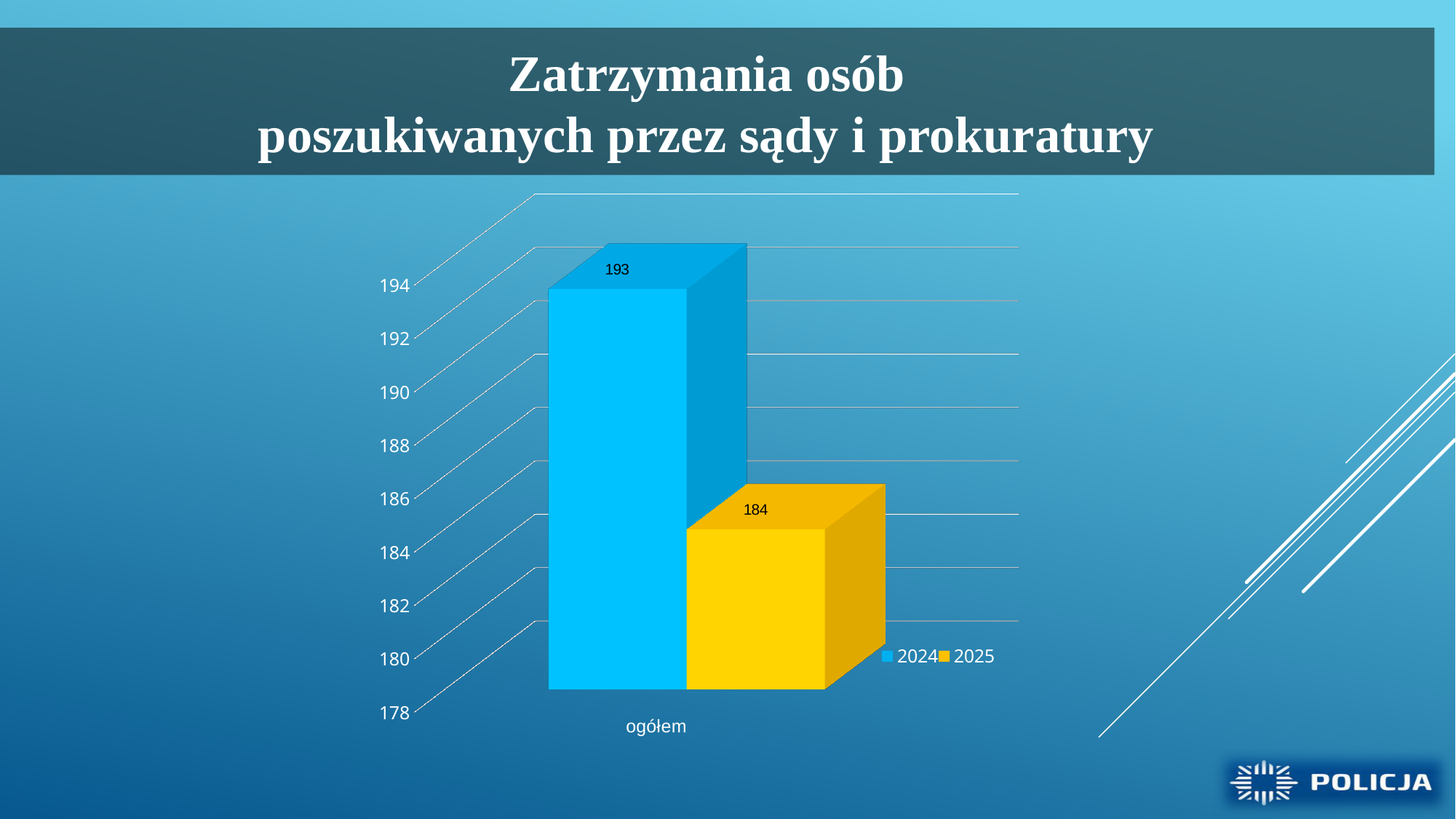
How many categories are shown on the x axis? 1 What kind of chart is shown on the slide? bar chart Is the value for 2024 greater or less than 190? greater What is the label of the category on the x axis? ogółem What is the value for 2024 in the 'ogółem' category? 193 What is the value for 2025 in the 'ogółem' category? 184 Is the value for 2025 greater or less than 190? less Which series has the lowest value on the chart? 2025 Which series is shown in yellow in the legend? 2025 How many series does the legend list? 2 What is the difference between the 2024 and 2025 values for 'ogółem'? 9 Which series has the higher value for 'ogółem', 2024 or 2025? 2024